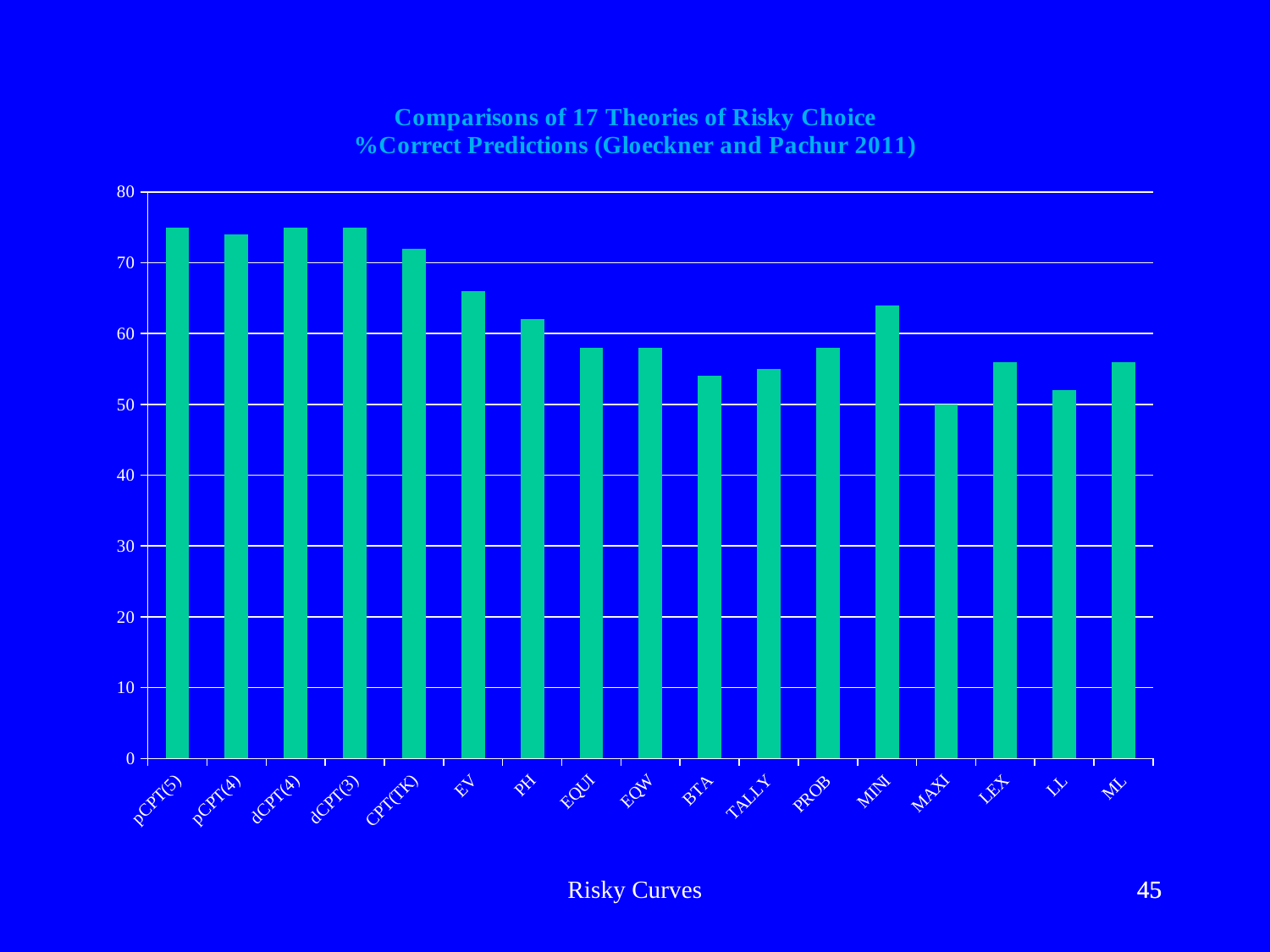
What is the title of the chart? Comparisons of 17 Theories of Risky Choice %Correct Predictions (Gloeckner and Pachur 2011) Is the value for LL greater or less than 60? less How many theories (categories) are plotted on the x axis? 17 Which has a higher value, CPT(TK) or EV? CPT(TK) Is the value for MINI greater or less than 60? greater Is the value for EV greater or less than 70? less Which has a higher value, MINI or MAXI? MINI What is the highest value shown on the y axis? 80 What kind of chart is shown on the slide? bar chart Which theory has the lowest percentage of correct predictions? MAXI